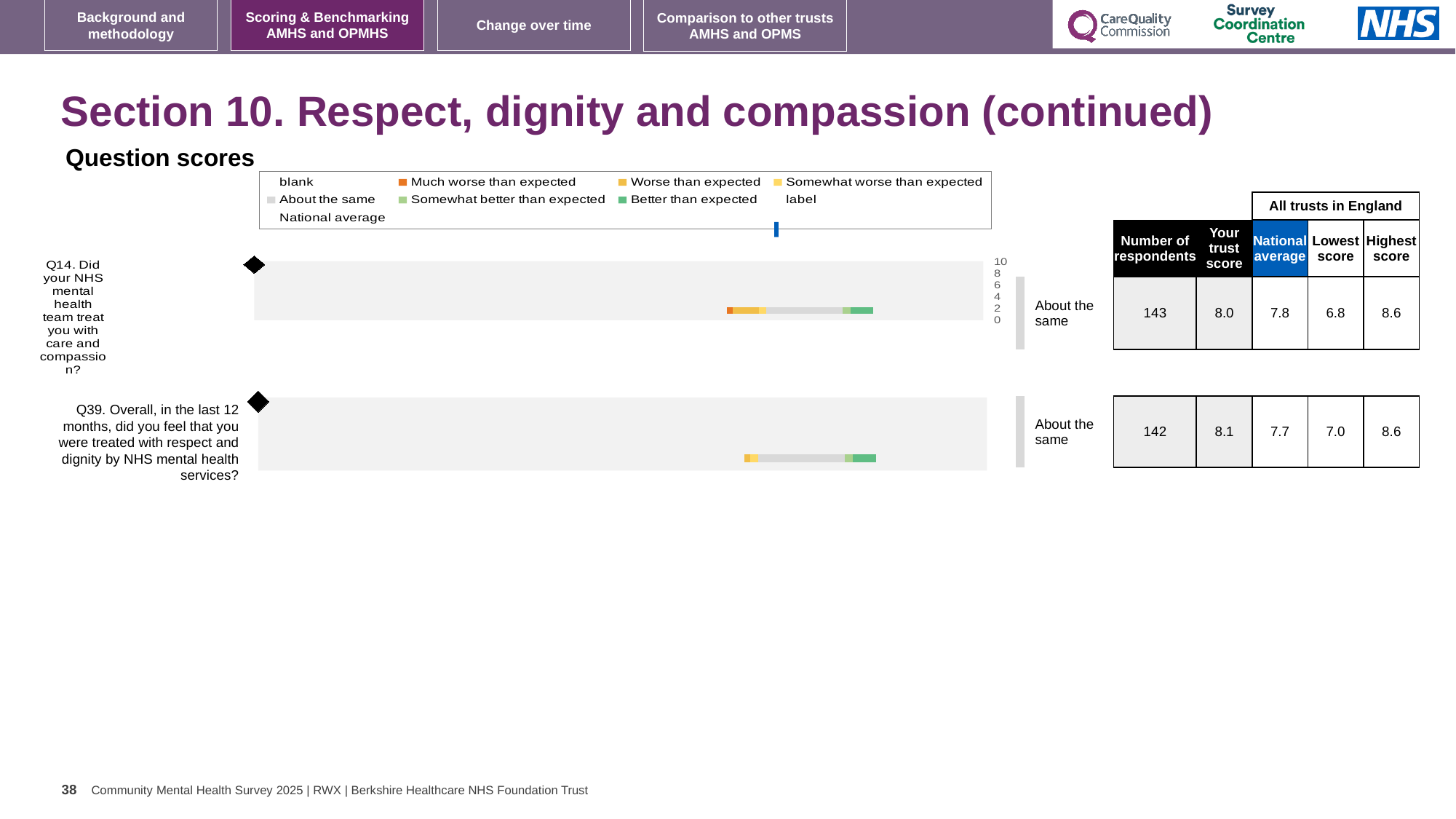
What benchmark category is shown for Q14? About the same How many questions are plotted in the chart? 2 What kind of chart is used to show the question scores? bar chart What is the lowest score among all trusts in England for Q39? 7.0 What is the highest score among all trusts in England for Q14? 8.6 Which question has the higher trust score, Q14 or Q39? Q39 How many respondents answered Q14 according to the table? 143 What is the trust's score for Q39? 8.1 What is the national average score for Q14? 7.8 What is the difference between the highest and lowest scores for Q39? 1.6 By how much does the trust's score for Q14 exceed the national average for Q14? 0.2 What is the lowest score among all trusts in England for Q14? 6.8